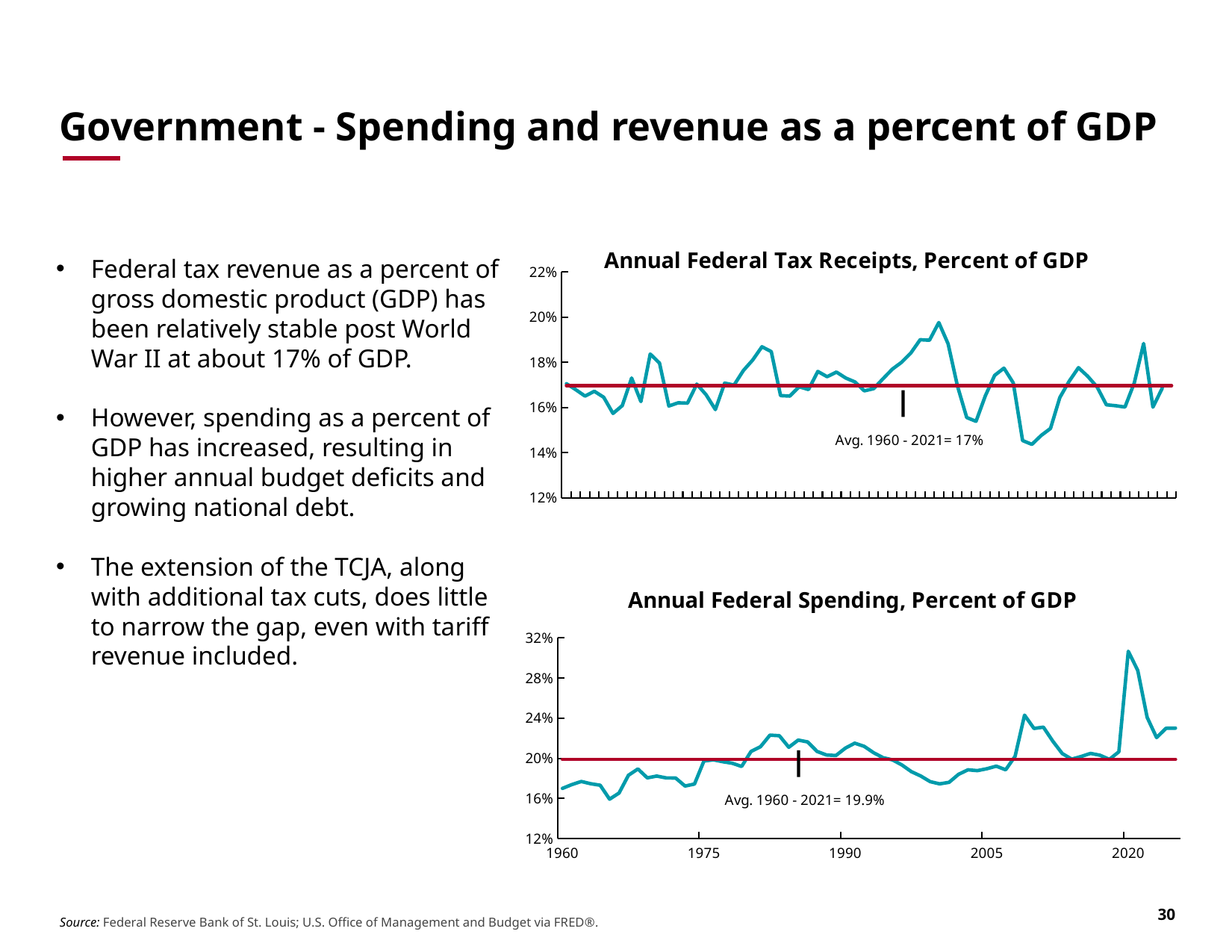
In the 'Annual Federal Spending, Percent of GDP' chart, is the value for 2020 greater or less than 28%? greater In the 'Annual Federal Tax Receipts, Percent of GDP' chart, is the lowest point on the line greater or less than 16%? less Which is higher: the 1960 - 2021 average in the 'Annual Federal Tax Receipts' chart or the 1960 - 2021 average in the 'Annual Federal Spending' chart? Annual Federal Spending In the 'Annual Federal Spending, Percent of GDP' chart, what is the average for 1960 - 2021? 19.9% What is the highest value shown on the y axis of the 'Annual Federal Spending, Percent of GDP' chart? 32% What does the red horizontal line in each chart represent? The 1960 - 2021 average In the 'Annual Federal Tax Receipts, Percent of GDP' chart, what is the average for 1960 - 2021? 17% In the 'Annual Federal Spending, Percent of GDP' chart, is the value at the end of the line higher or lower than the value at 1960? higher What kind of chart is used for 'Annual Federal Tax Receipts, Percent of GDP'? Line chart In the 'Annual Federal Spending, Percent of GDP' chart, is the value for 1960 greater or less than 20%? less What is the difference between the 1960 - 2021 average in the 'Annual Federal Spending' chart and the 1960 - 2021 average in the 'Annual Federal Tax Receipts' chart? 2.9 percentage points How many year labels are shown on the x axis of the 'Annual Federal Spending, Percent of GDP' chart? 5